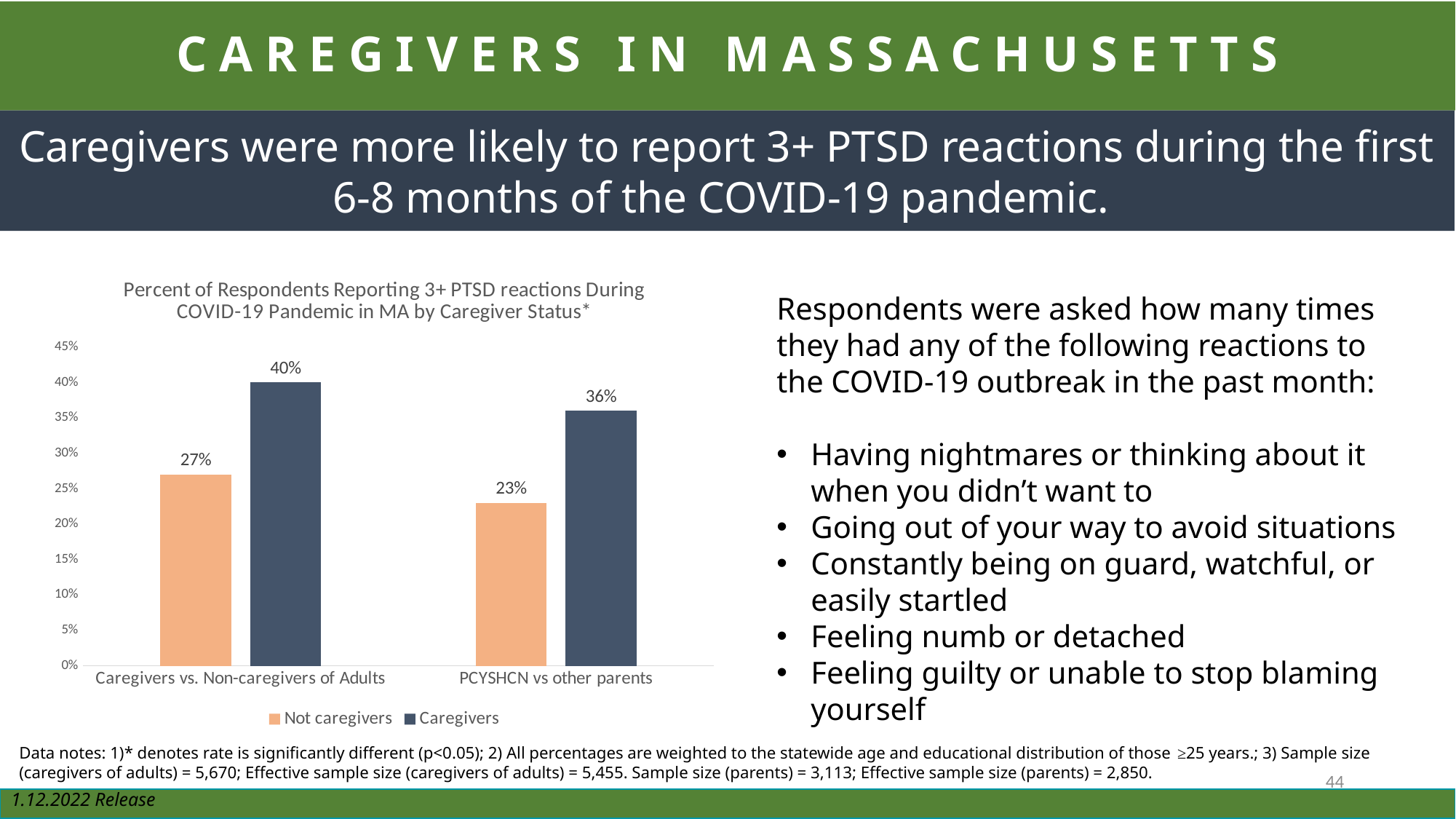
What type of chart is shown on the slide? Bar chart What is the value for Caregivers in the 'PCYSHCN vs other parents' group? 36% Which bar in the chart has the highest value? Caregivers in Caregivers vs. Non-caregivers of Adults (40%) Which bar in the chart has the lowest value? Not caregivers in PCYSHCN vs other parents (23%) How many series does the chart legend list? 2 What percent of Not caregivers reported 3+ PTSD reactions in the 'PCYSHCN vs other parents' group? 23% What colour represents the Not caregivers series in the chart? Orange What is the difference between Caregivers and Not caregivers in the 'PCYSHCN vs other parents' group? 13% What percent of Caregivers reported 3+ PTSD reactions in the 'Caregivers vs. Non-caregivers of Adults' group? 40% In the 'PCYSHCN vs other parents' group, which is larger: Caregivers or Not caregivers? Caregivers What is the value for Not caregivers in the 'Caregivers vs. Non-caregivers of Adults' group? 27% What is the difference between Caregivers and Not caregivers in the 'Caregivers vs. Non-caregivers of Adults' group? 13%